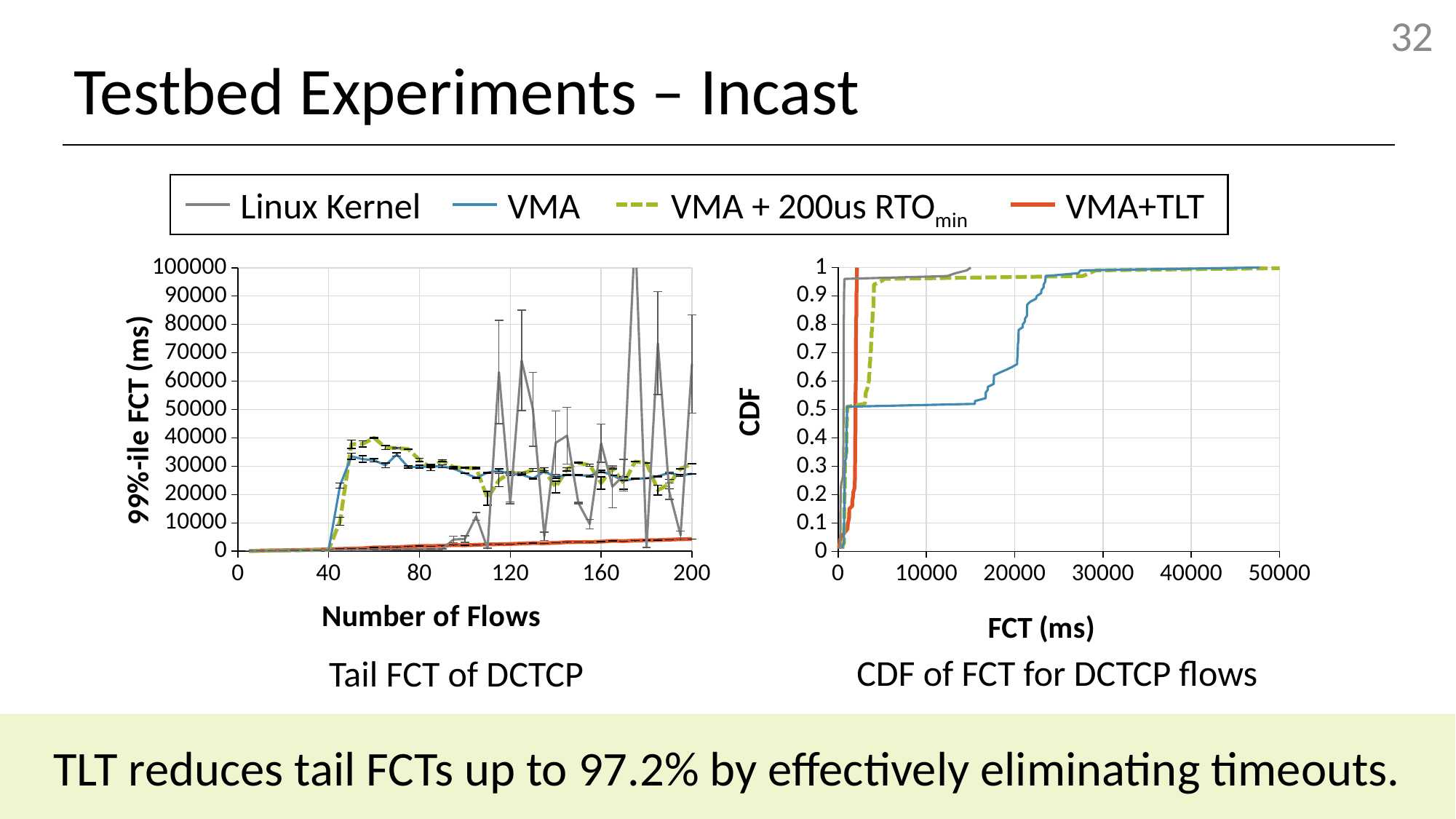
What kind of chart is the 'Tail FCT of DCTCP' chart on the left? line chart How many series does the shared legend list? 4 In the 'CDF of FCT for DCTCP flows' chart, is the CDF value for VMA at 10000 ms greater or less than 0.6? less In the 'Tail FCT of DCTCP' chart, at 60 flows, which is larger: VMA + 200us RTOmin or VMA+TLT? VMA + 200us RTOmin In the 'Tail FCT of DCTCP' chart, what is the label of the y axis? 99%-ile FCT (ms) In the 'CDF of FCT for DCTCP flows' chart, which series reaches a CDF of 1 at the smallest FCT? VMA+TLT In the 'Tail FCT of DCTCP' chart, is the peak value for Linux Kernel near 175 flows greater or less than 90000? greater In the 'CDF of FCT for DCTCP flows' chart, is the CDF value for VMA + 200us RTOmin at 10000 ms greater or less than 0.9? greater In the 'Tail FCT of DCTCP' chart, which series has the lowest 99%-ile FCT at 200 flows? VMA+TLT In the 'CDF of FCT for DCTCP flows' chart, what is the label of the x axis? FCT (ms)